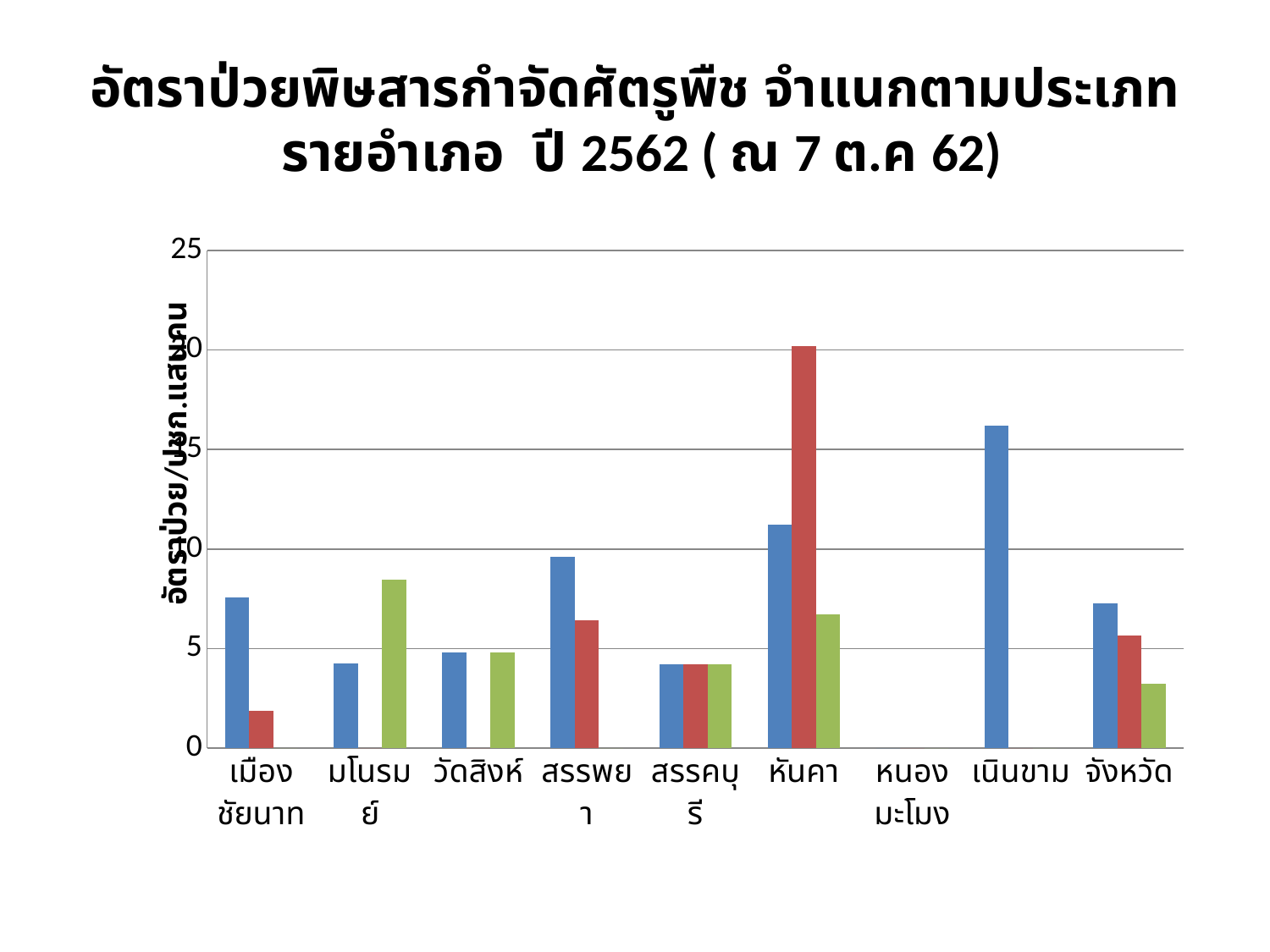
Which is larger: the red bar for หันคา or the red bar for จังหวัด? หันคา Which is larger: the blue bar for สรรพยา or the blue bar for มโนรมย์? สรรพยา Which category has the tallest bar in the chart? หันคา Which category shows no bars at all in the chart? หนองมะโมง How many categories are shown along the x axis of the chart? 9 Which category has the tallest blue bar in the chart? เนินขาม Is the value of the blue bar for เนินขาม greater or less than 15? greater What is the highest value shown on the y axis of the chart? 25 Is the value of the blue bar for หันคา greater or less than 10? greater What kind of chart is shown on the slide? Bar chart Is the value of the blue bar for สรรพยา greater or less than 10? less